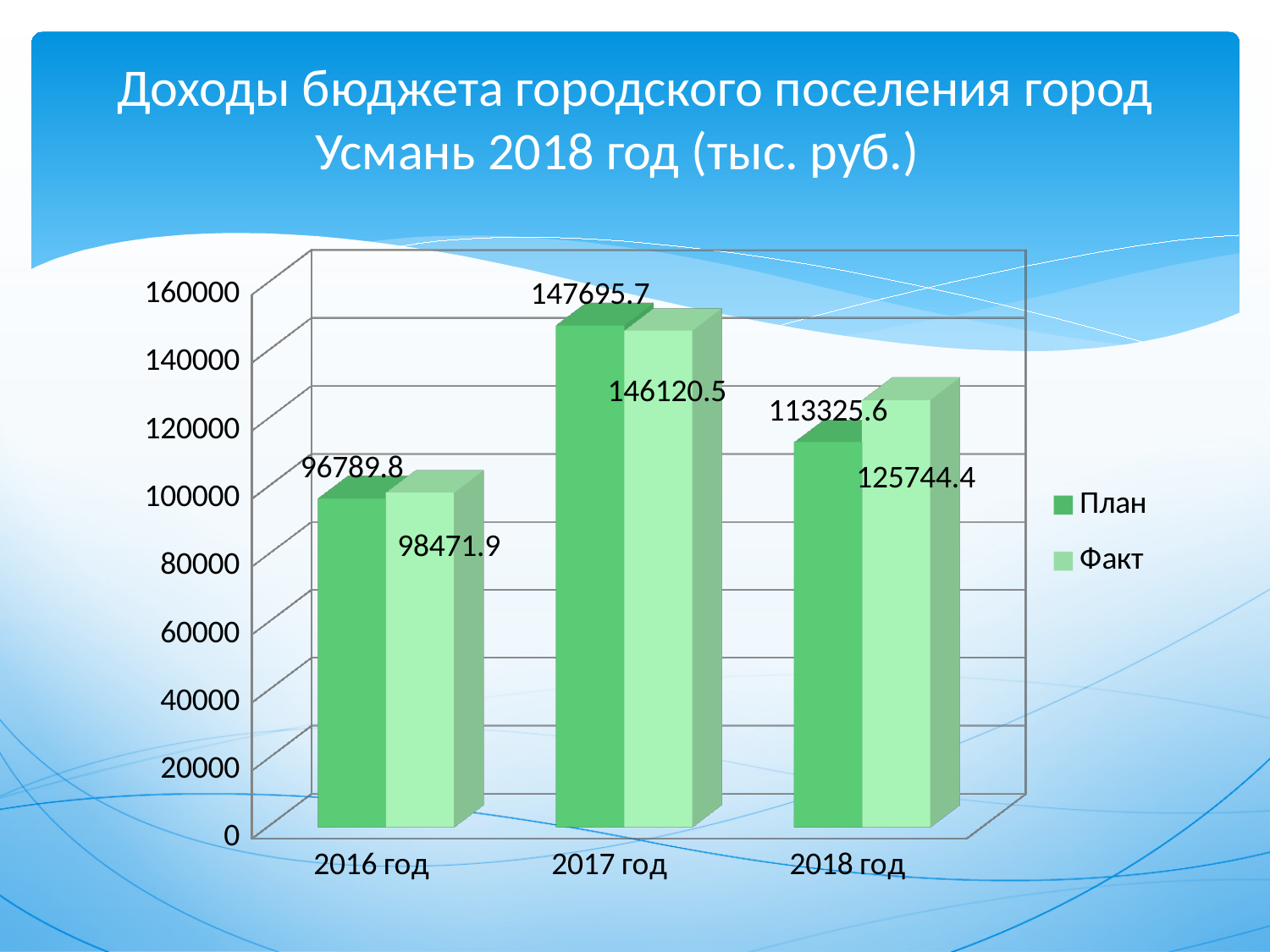
What is the План value for 2017 год? 147695.7 What are the two series named in the legend? План and Факт In which year is the План value the highest? 2017 год In which year is the Факт value the lowest? 2016 год How many years are shown on the x axis? 3 For 2018 год, which is larger: План or Факт? Факт Is the План value for 2016 год greater or less than 100000? less What kind of chart is shown on the slide? bar chart What is the difference between the Факт and План values for 2018 год? 12418.8 How many series does the legend list? 2 What is the Факт value for 2016 год? 98471.9 What is the Факт value for 2018 год? 125744.4